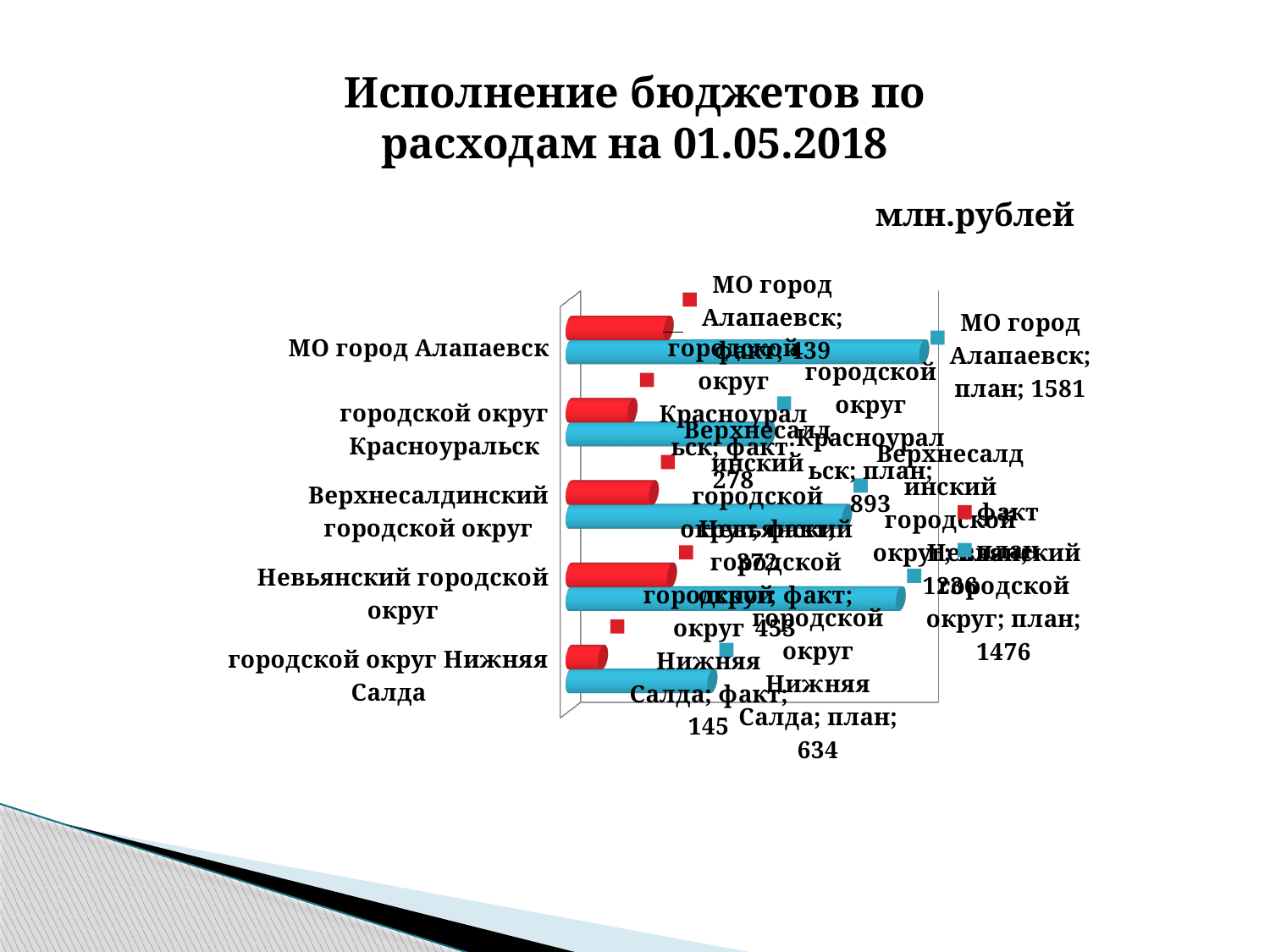
What kind of chart is shown on the slide? bar chart What is the план value for городской округ Нижняя Салда? 634 What is the план value for городской округ Красноуральск? 893 How many municipalities (categories) are shown in the chart? 5 What is the план value for МО город Алапаевск? 1581 In what units are the values on the chart expressed? млн.рублей Which municipality has the lowest план value? городской округ Нижняя Салда What is the план value for Невьянский городской округ? 1476 What is the факт value for городской округ Нижняя Салда? 145 What is the факт value for городской округ Красноуральск? 278 What is the difference between the план and факт values for городской округ Красноуральск? 615 Which municipality has the highest план value? МО город Алапаевск